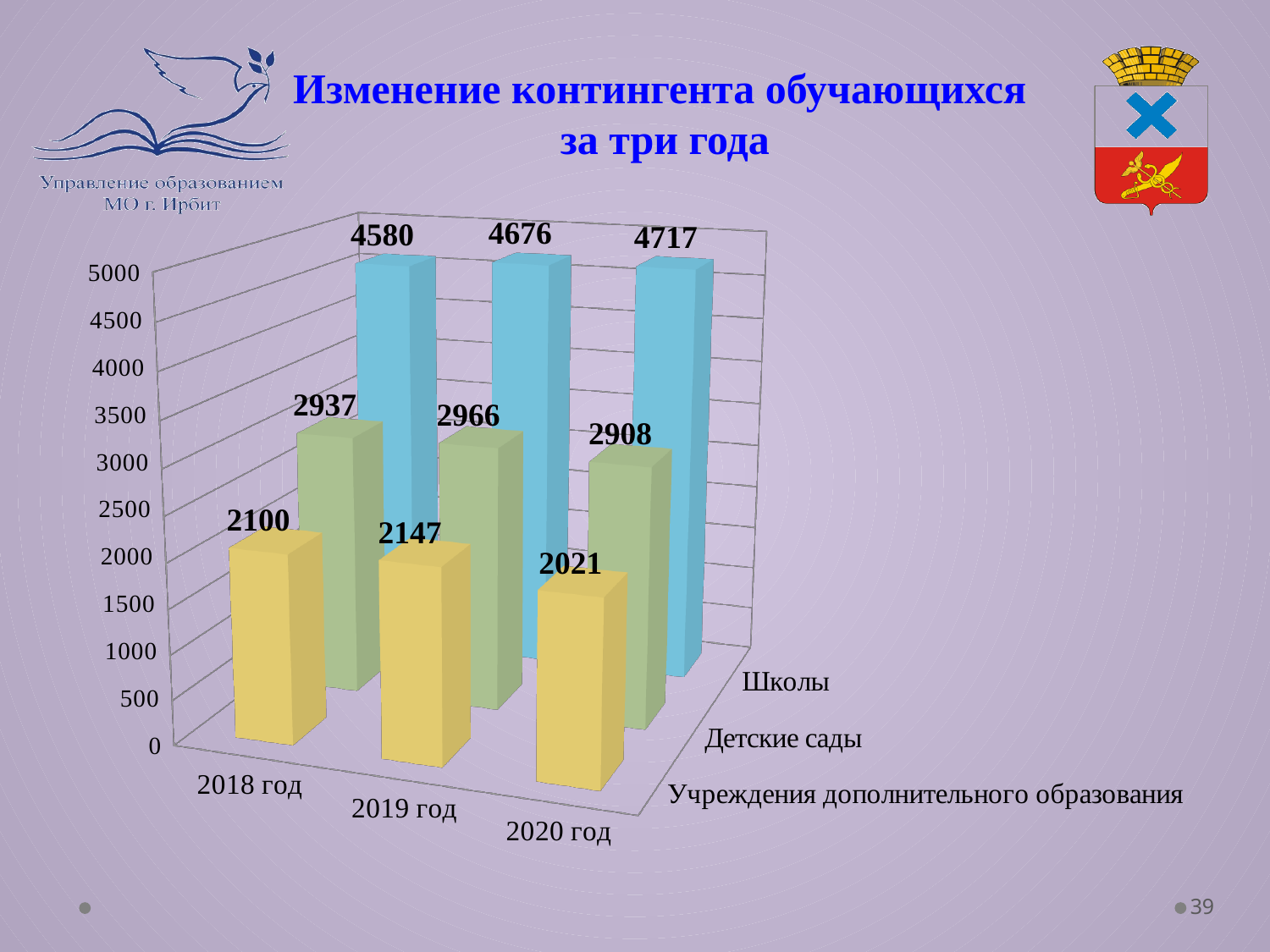
How many years are shown on the x axis? 3 In which year is the value for Учреждения дополнительного образования lowest? 2020 год What is the value for Учреждения дополнительного образования in 2019 год? 2147 What kind of chart is shown on the slide? bar chart What is the difference between the Школы values for 2020 год and 2018 год? 137 Is the value for Школы in 2018 год greater or less than 4500? greater What is the value for Школы in 2020 год? 4717 Do the values for Школы rise or fall from 2018 год to 2020 год? rise How many series does the chart show? 3 Which is larger: Детские сады in 2019 год or Детские сады in 2020 год? 2019 год In which year is the value for Школы highest? 2020 год What is the value for Детские сады in 2018 год? 2937